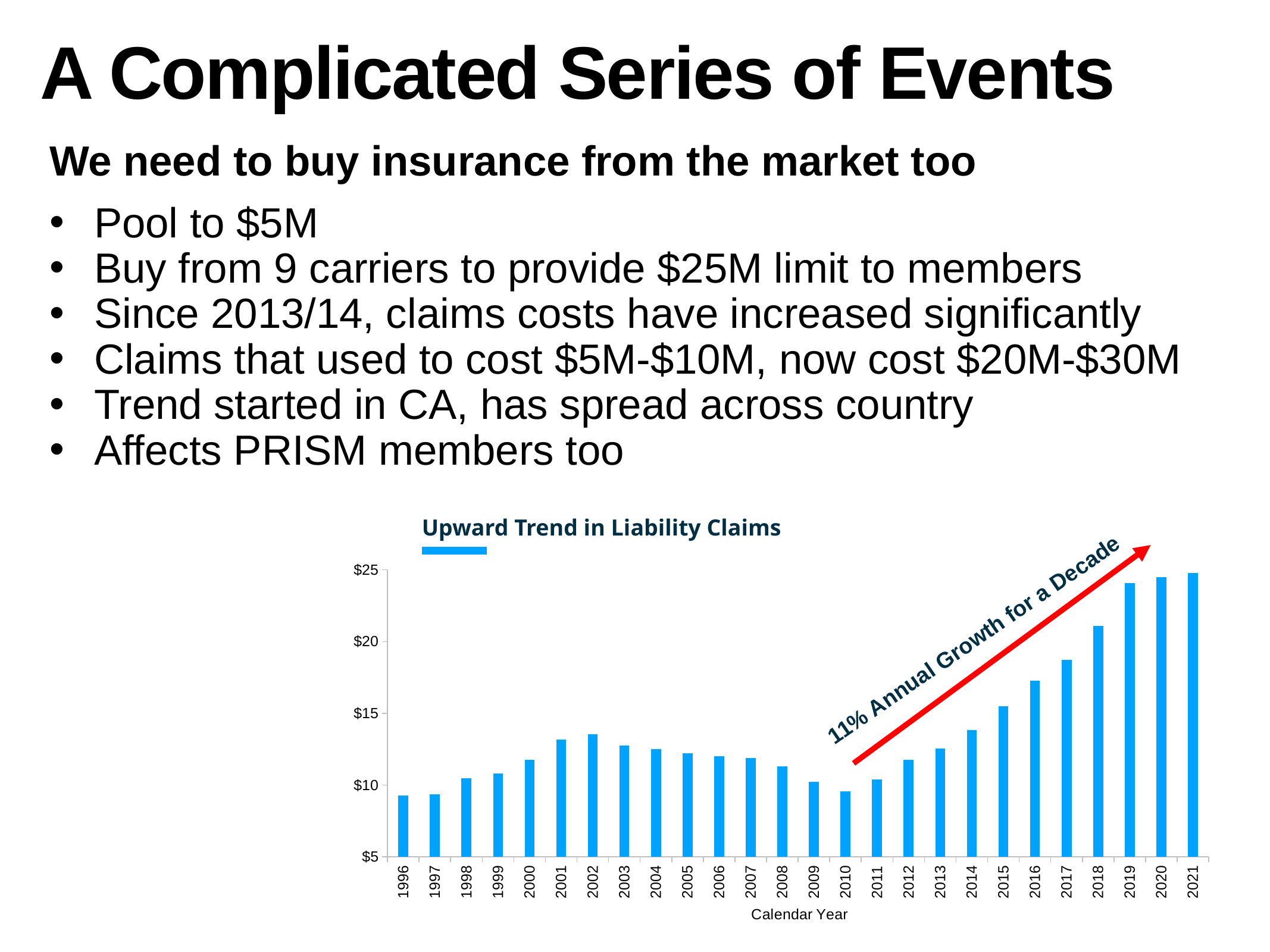
Is the value for 2021 greater or less than $20? greater Is the value for 2016 greater or less than $15? greater Which is larger, the value for 2002 or the value for 2010? 2002 What kind of chart is shown on the slide? bar chart Is the value for 1996 greater or less than $10? less What is the x-axis title of the chart? Calendar Year Which year has the highest value in the chart? 2021 What is the title of the chart? Upward Trend in Liability Claims How many years (bars) are plotted in the chart? 26 Which is larger, the value for 2019 or the value for 2013? 2019 Do the values rise or fall from 2010 to 2021? rise